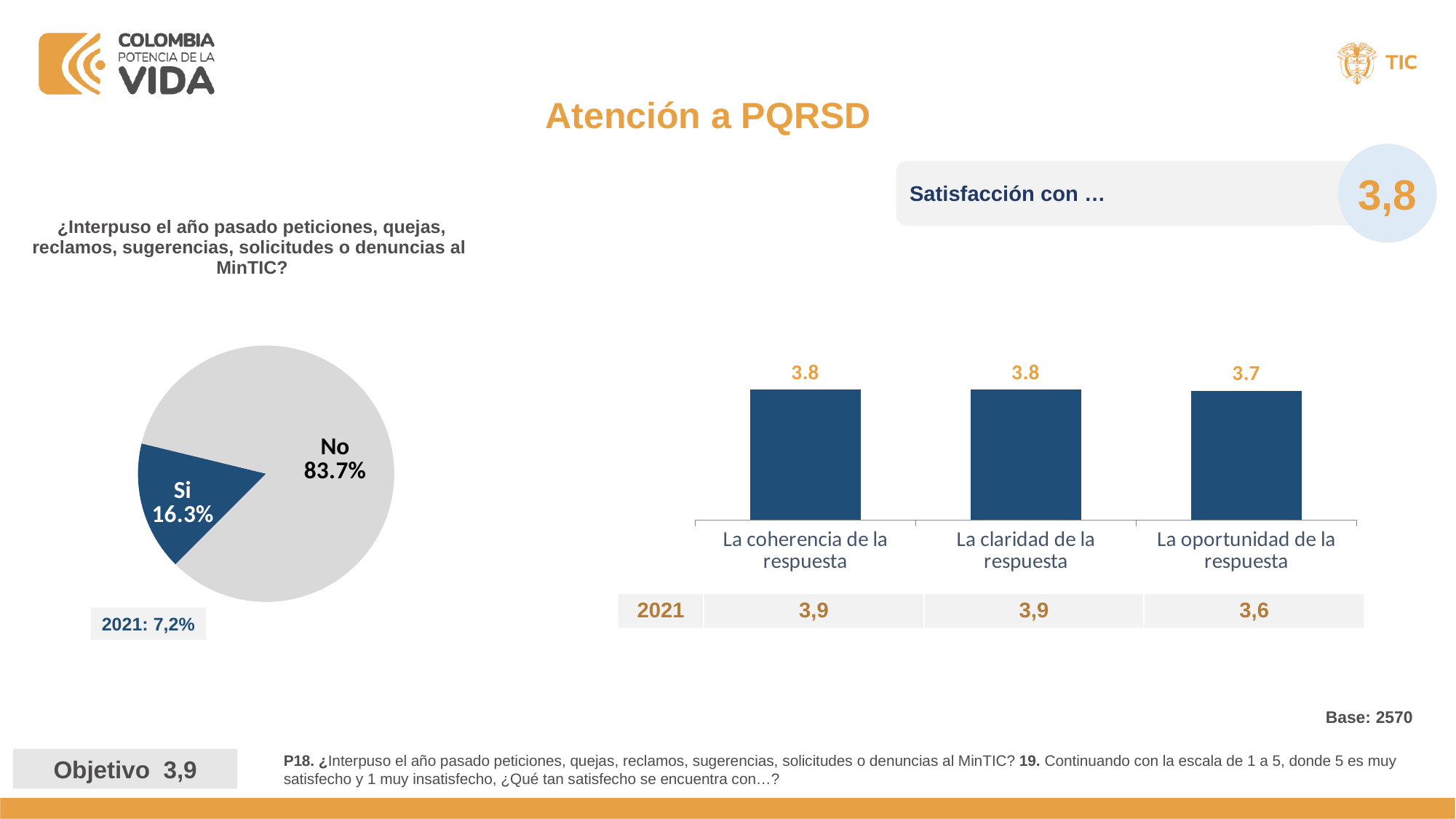
In the pie chart on the left, what percentage of respondents answered "Si"? 16.3% In the pie chart on the left, how many slices are there? 2 What kind of chart is shown on the right side of the slide? Bar chart In the bar chart on the right, how many categories are shown? 3 In the pie chart on the left, which slice is larger, "Si" or "No"? No In the bar chart on the right, which category has the lowest value? La oportunidad de la respuesta In the bar chart on the right, what is the value for "La coherencia de la respuesta"? 3.8 In the pie chart on the left, what percentage of respondents answered "No"? 83.7% In the bar chart on the right, what is the difference between the values for "La claridad de la respuesta" and "La oportunidad de la respuesta"? 0.1 In the bar chart on the right, what was the 2021 value for "La oportunidad de la respuesta" shown in the table below the bars? 3,6 In the bar chart on the right, what is the value for "La oportunidad de la respuesta"? 3.7 What kind of chart is shown on the left side of the slide? Pie chart